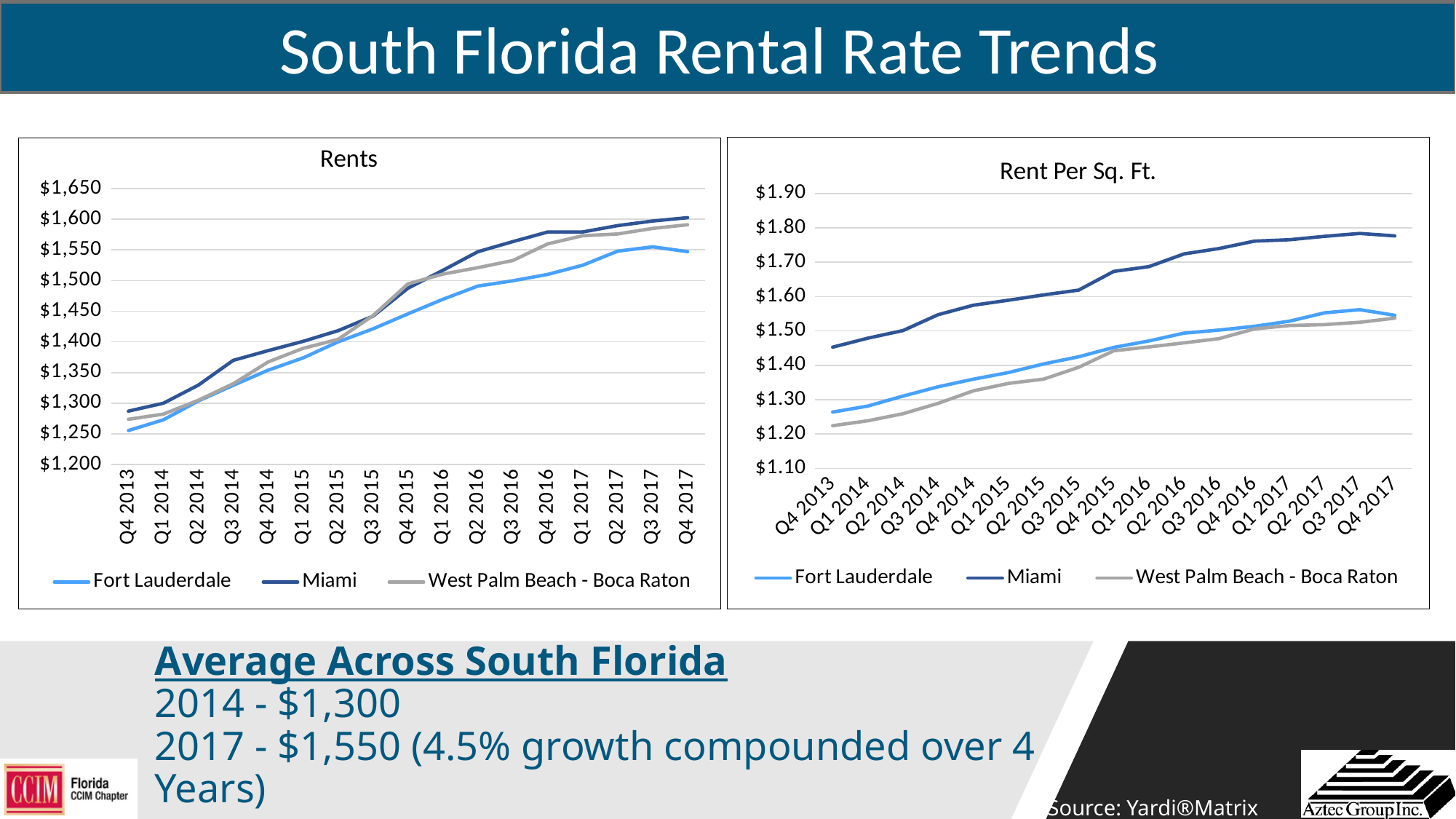
What kind of chart is the "Rents" chart on the left? line chart In the "Rents" chart, does the Miami line rise or fall from Q4 2013 to Q4 2017? rise In the "Rent Per Sq. Ft." chart, is the value for West Palm Beach - Boca Raton in Q4 2013 greater or less than $1.30? less In the "Rent Per Sq. Ft." chart, which series has the lowest value in Q4 2013? West Palm Beach - Boca Raton In the "Rents" chart, is the value for Miami in Q4 2016 greater or less than $1,550? greater What is the title of the chart on the right side of the slide? Rent Per Sq. Ft. In the "Rents" chart, is the value for Fort Lauderdale in Q4 2013 greater or less than $1,300? less How many series does the legend of the "Rent Per Sq. Ft." chart list? 3 In the "Rent Per Sq. Ft." chart, which series has the highest value in Q4 2017? Miami In the "Rents" chart, which is larger in Q4 2017: Miami or Fort Lauderdale? Miami How many quarters are plotted along the x axis of the "Rents" chart? 17